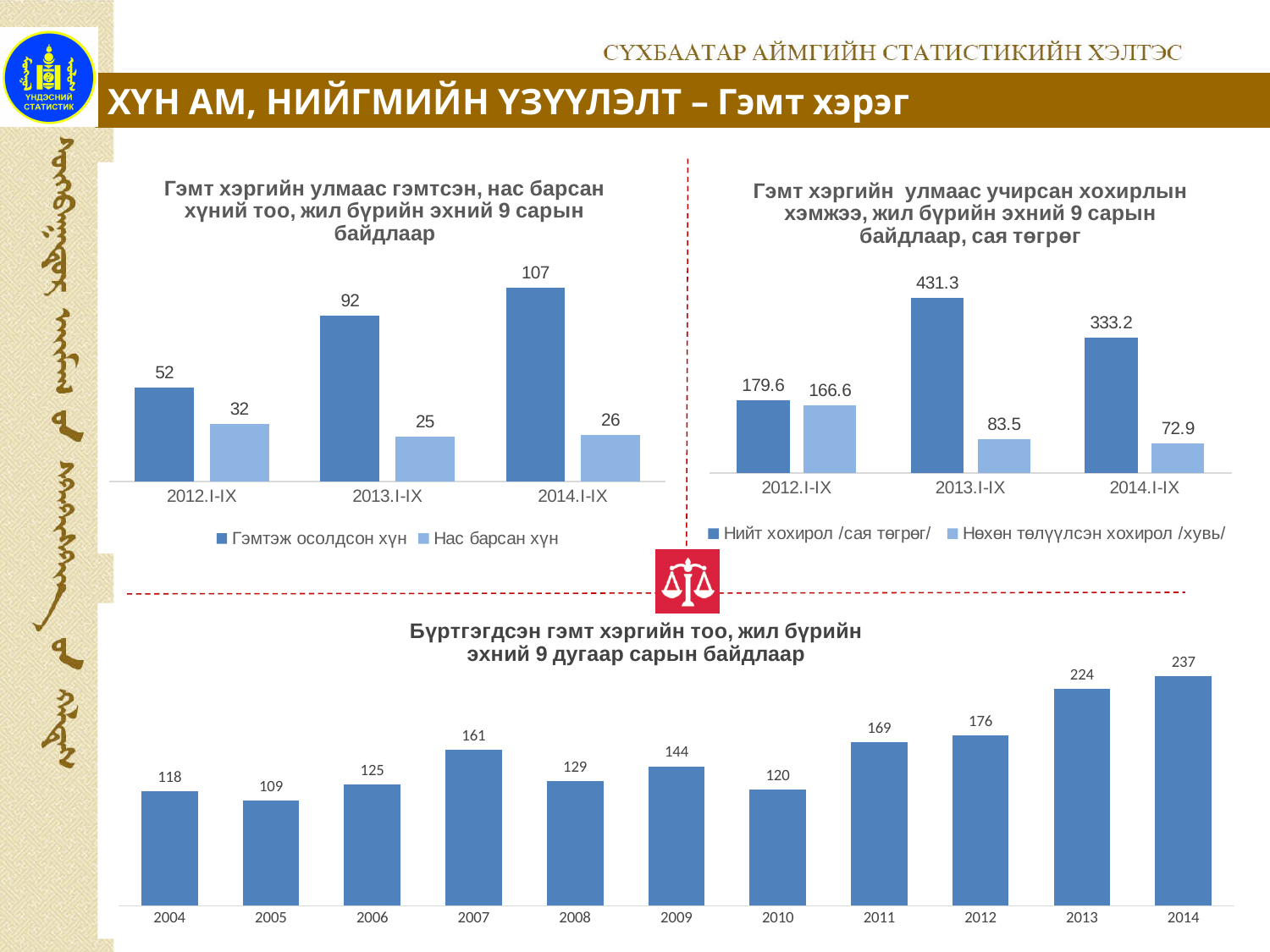
In the top-left chart, what is the value for Нас барсан хүн in 2012.I-IX? 32 In the bottom chart (Бүртгэгдсэн гэмт хэргийн тоо), which is larger, the value for 2007 or the value for 2008? 2007 In the bottom chart (Бүртгэгдсэн гэмт хэргийн тоо), how many years are shown on the x axis? 11 In the bottom chart (Бүртгэгдсэн гэмт хэргийн тоо), which year has the lowest value? 2005 In the bottom chart (Бүртгэгдсэн гэмт хэргийн тоо), what is the value for 2014? 237 In the top-left chart, what is the value for Гэмтэж осолдсон хүн in 2013.I-IX? 92 What kind of chart is the bottom chart (Бүртгэгдсэн гэмт хэргийн тоо)? bar chart In the top-left chart, how many series does the legend list? 2 In the top-right chart, what is the value for Нийт хохирол /сая төгрөг/ in 2013.I-IX? 431.3 In the bottom chart (Бүртгэгдсэн гэмт хэргийн тоо), what is the difference between the values for 2014 and 2004? 119 In the top-left chart, does the Гэмтэж осолдсон хүн series rise or fall from 2012.I-IX to 2014.I-IX? rise In the top-right chart, which period has the highest value for Нөхөн төлүүлсэн хохирол /хувь/? 2012.I-IX